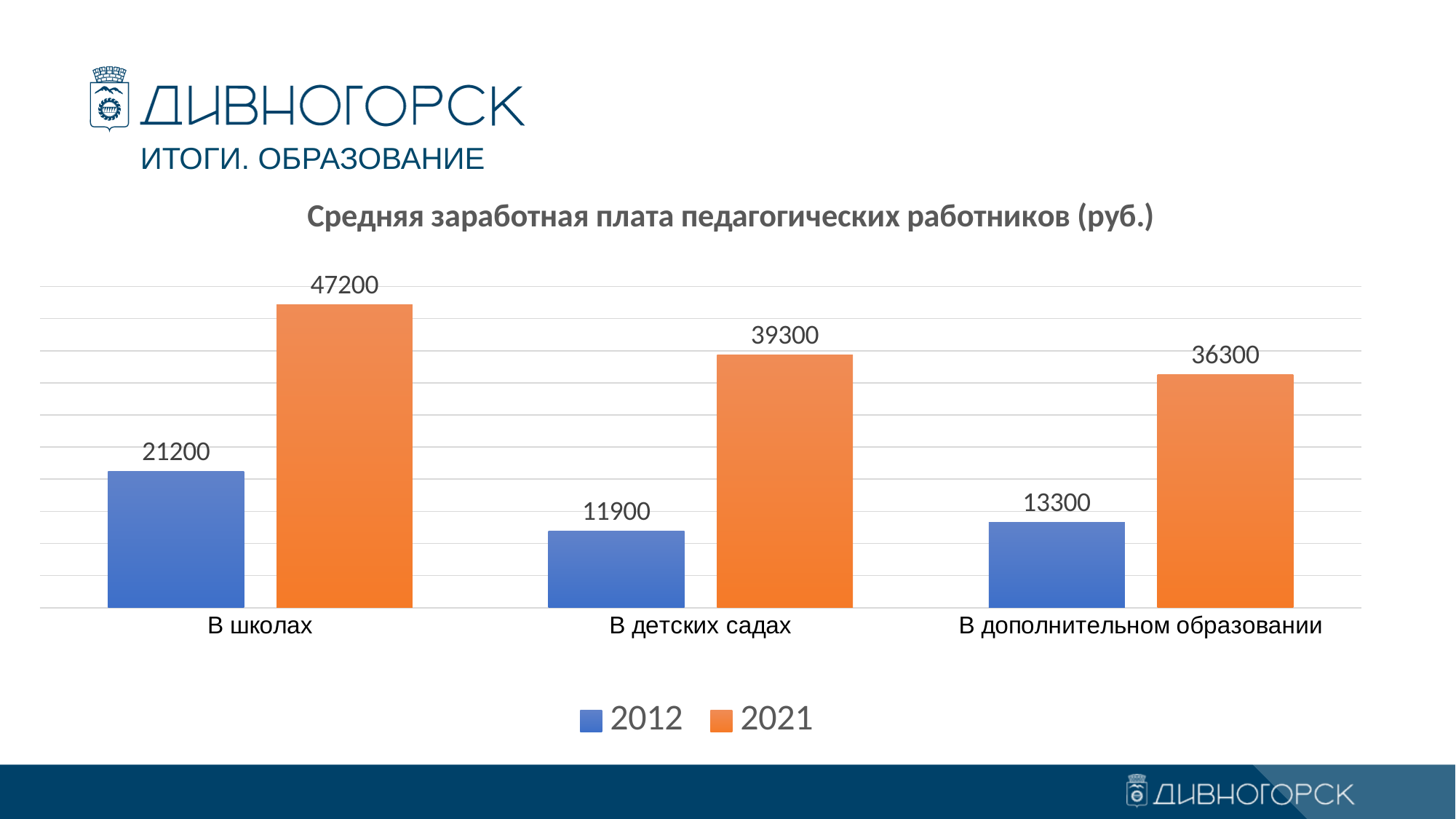
Which category has the highest value for 2021? В школах How many categories are shown on the x axis? 3 What is the average salary of teaching staff in kindergartens (В детских садах) in 2012? 11900 What is the average salary of teaching staff in schools (В школах) in 2012? 21200 What type of chart is shown on the slide? Bar chart How many series does the legend list? 2 Which is larger: the 2012 value for kindergartens (В детских садах) or the 2012 value for additional education (В дополнительном образовании)? В дополнительном образовании What is the difference between the 2021 values for kindergartens (В детских садах) and additional education (В дополнительном образовании)? 3000 What is the difference between the 2021 and 2012 values for schools (В школах)? 26000 What is the average salary of teaching staff in schools (В школах) in 2021? 47200 Which category has the lowest value for 2012? В детских садах What is the average salary in additional education (В дополнительном образовании) in 2021? 36300